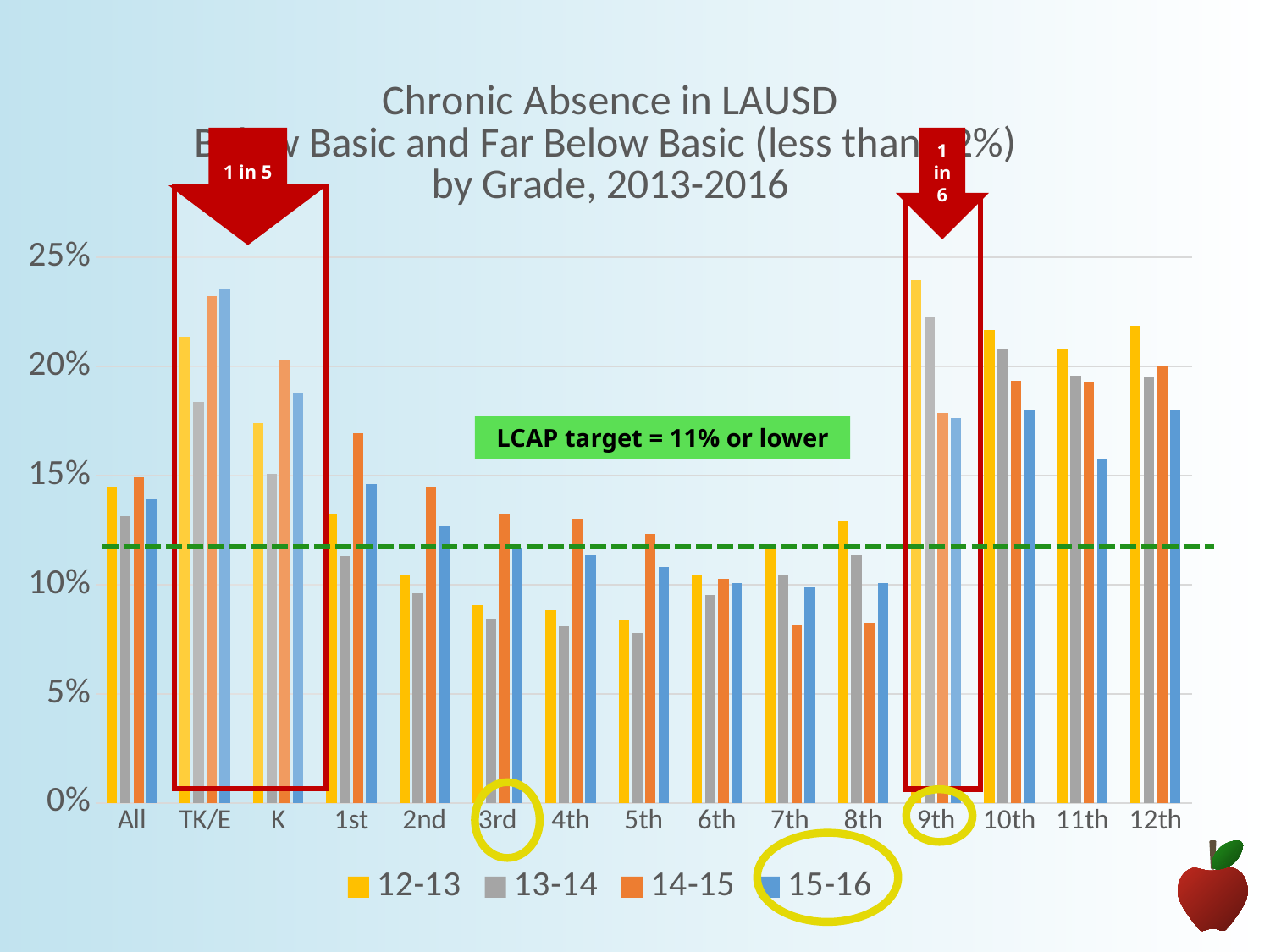
Is the 13-14 value for 5th grade greater or less than 10%? less Which grade has the highest 12-13 value? 9th How many grade categories are shown along the x axis? 15 What kind of chart is shown on the slide? bar chart Is the 12-13 value for 9th grade greater or less than 20%? greater Is the 15-16 value for TK/E greater or less than 20%? greater Do the 12-13 values rise or fall from TK/E through 3rd grade? fall How many series does the legend list? 4 Which grade has the highest 15-16 value? TK/E For 9th grade, which is larger: the 12-13 value or the 15-16 value? 12-13